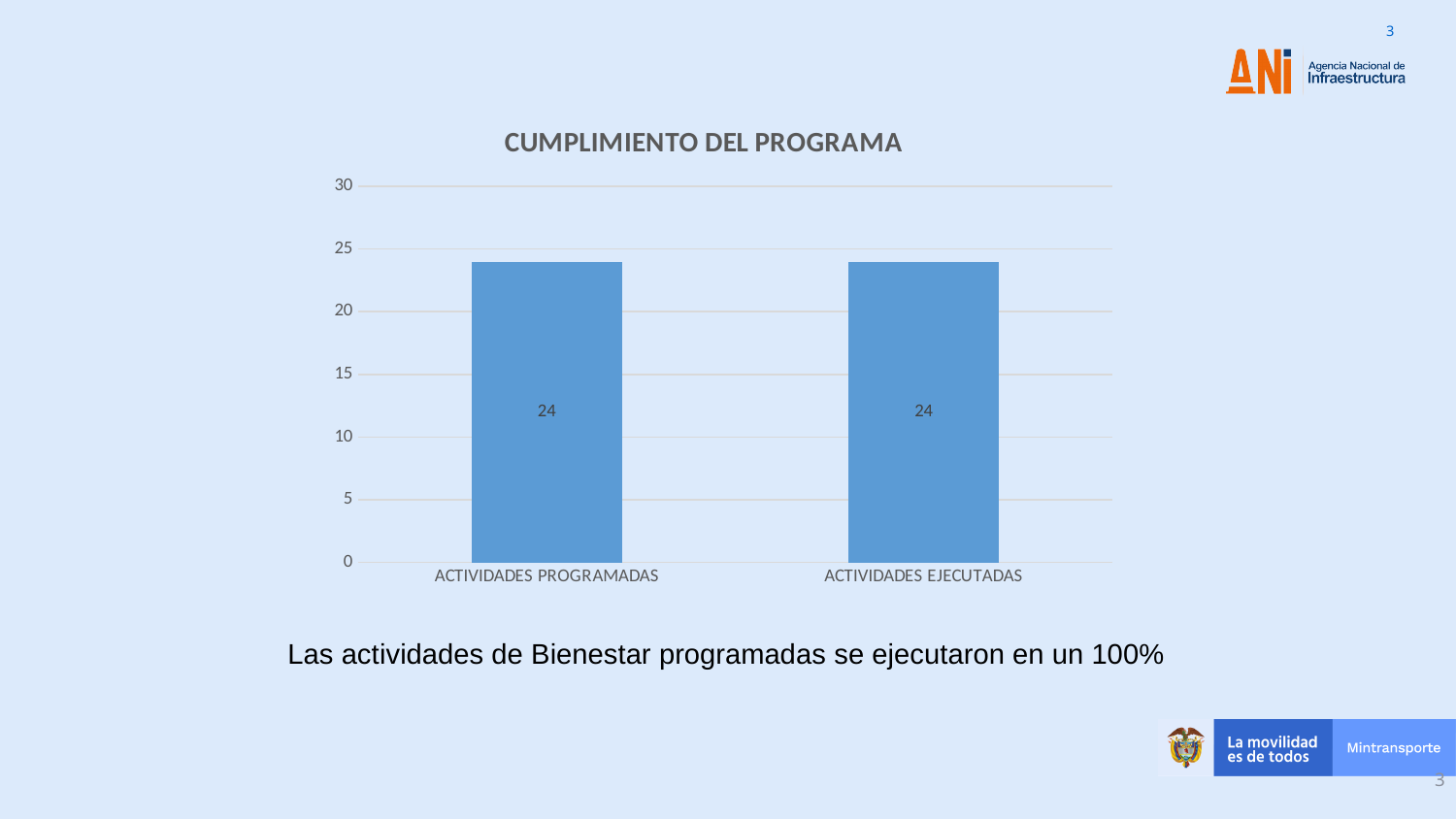
What kind of chart is shown on the slide? bar chart What is the maximum value shown on the y axis? 30 What is the difference between the values for ACTIVIDADES PROGRAMADAS and ACTIVIDADES EJECUTADAS? 0 Do the values for ACTIVIDADES PROGRAMADAS and ACTIVIDADES EJECUTADAS differ, or are they equal? equal Is the value for ACTIVIDADES PROGRAMADAS greater or less than 25? less What is the title of the chart? CUMPLIMIENTO DEL PROGRAMA What is the value for ACTIVIDADES EJECUTADAS? 24 Is the value for ACTIVIDADES EJECUTADAS greater or less than 20? greater What is the value for ACTIVIDADES PROGRAMADAS? 24 How many categories are shown on the x axis? 2